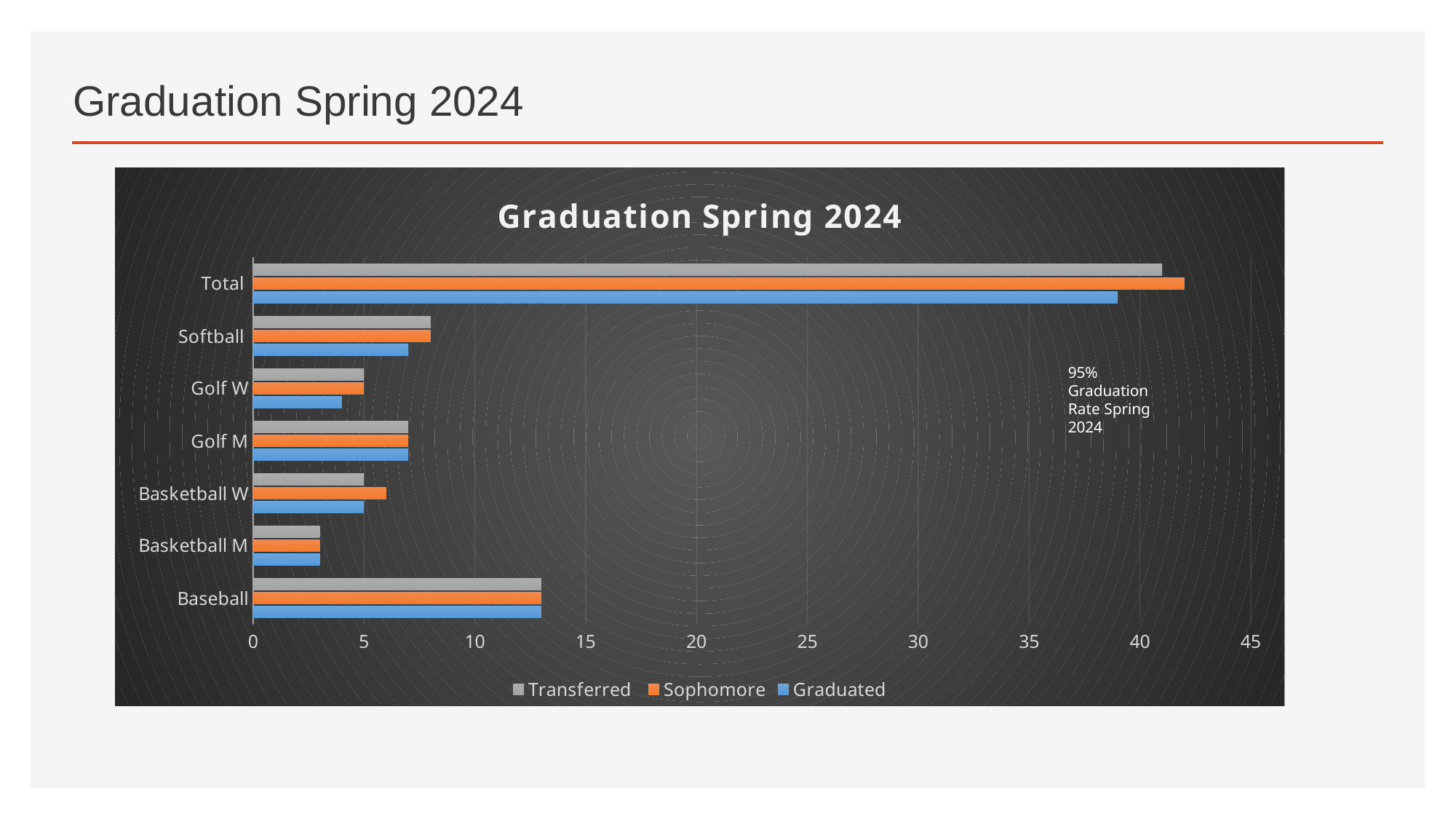
Excluding Total, which category has the lowest Graduated value? Basketball M How many series does the legend list? 3 Is the Transferred value for Baseball greater or less than 10? greater How many categories are shown on the vertical axis? 7 Which has the larger Graduated value, Baseball or Softball? Baseball What kind of chart is shown on the slide? bar chart Is the Sophomore value for Softball greater or less than 5? greater Which category has the highest Transferred value? Total Is the Sophomore value for Total greater or less than 40? greater For Total, which is larger, the Sophomore value or the Graduated value? Sophomore What is the title of the chart? Graduation Spring 2024